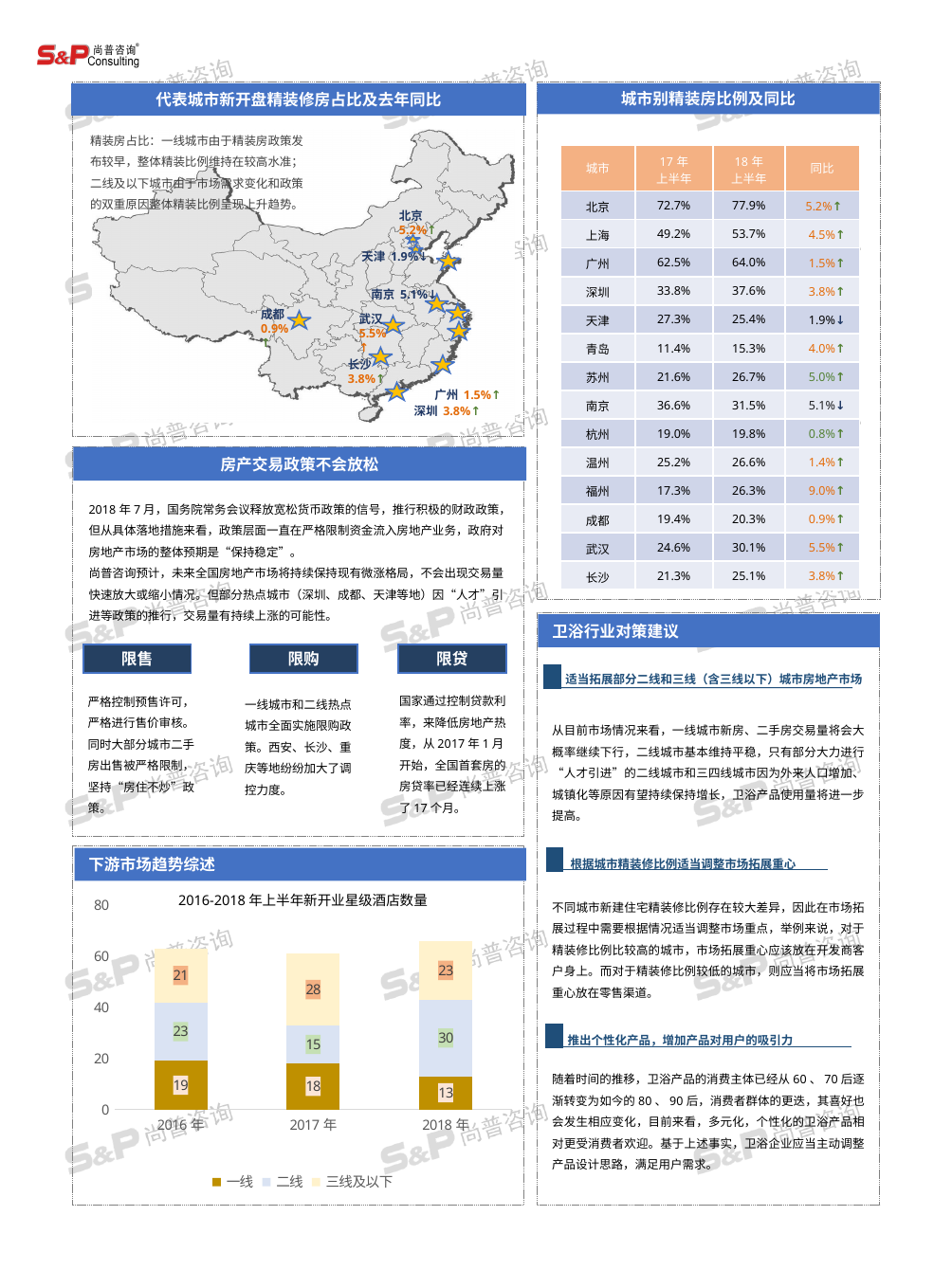
In the chart titled 2016-2018年上半年新开业星级酒店数量, which year has the lowest value for 一线? 2018年 In the chart titled 2016-2018年上半年新开业星级酒店数量, is the 三线及以下 value larger in 2017年 or in 2018年? 2017年 In the chart titled 2016-2018年上半年新开业星级酒店数量, what is the difference between the 二线 values for 2018年 and 2017年? 15 How many years are shown on the x axis of the chart titled 2016-2018年上半年新开业星级酒店数量? 3 What kind of chart is the chart titled 2016-2018年上半年新开业星级酒店数量? Stacked bar chart In the chart titled 2016-2018年上半年新开业星级酒店数量, what is the value for 二线 in 2018年? 30 In the chart titled 2016-2018年上半年新开业星级酒店数量, what is the value for 三线及以下 in 2017年? 28 In the chart titled 2016-2018年上半年新开业星级酒店数量, what is the total of the stacked bar for 2016年? 63 In the chart titled 2016-2018年上半年新开业星级酒店数量, which year has the highest value for 二线? 2018年 In the chart titled 2016-2018年上半年新开业星级酒店数量, what is the total of the stacked bar for 2018年? 66 In the chart titled 2016-2018年上半年新开业星级酒店数量, what is the value for 一线 in 2016年? 19 How many series does the legend of the chart titled 2016-2018年上半年新开业星级酒店数量 list? 3